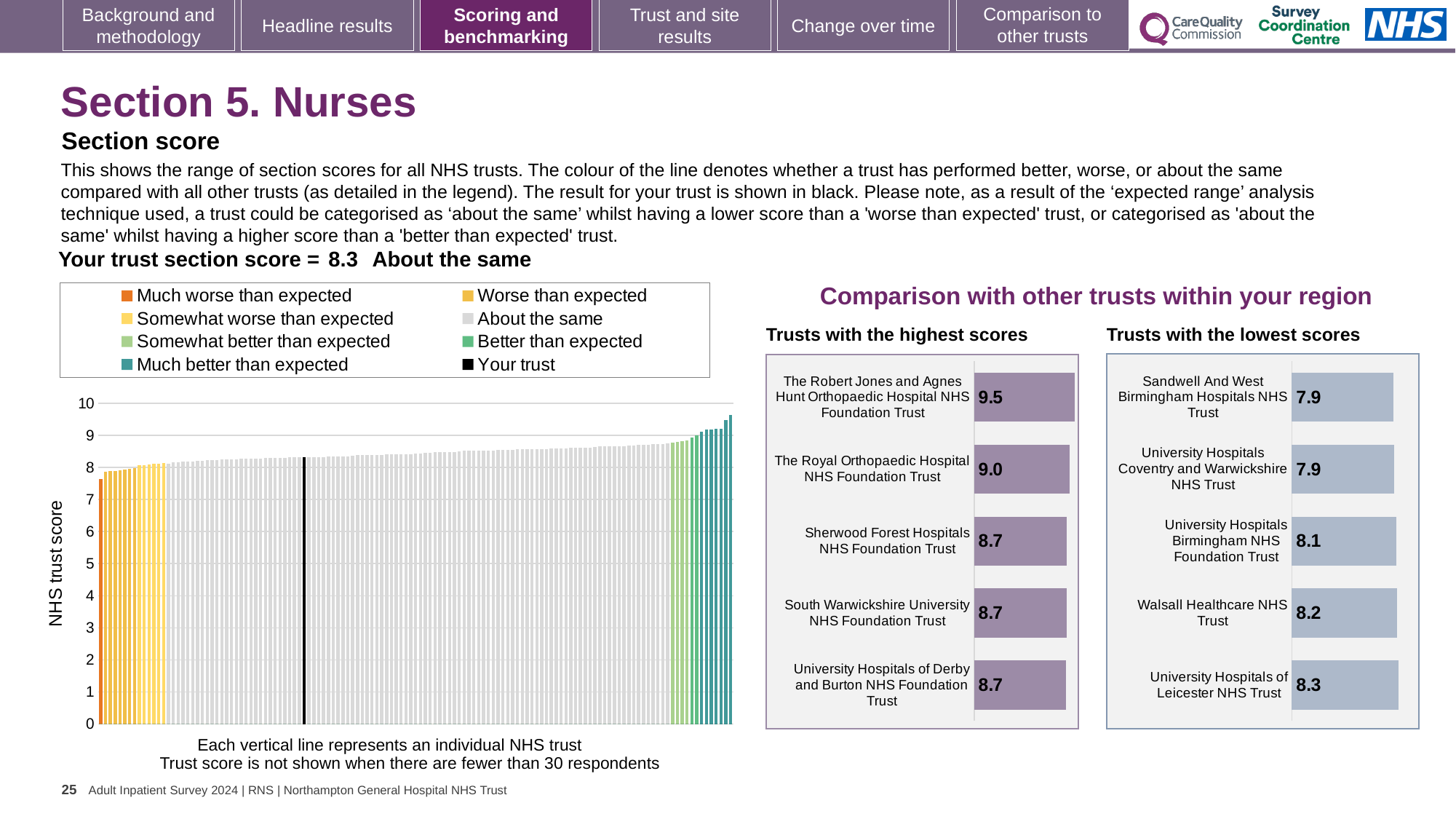
How many trusts are shown in the 'Trusts with the highest scores' chart? 5 In the 'Trusts with the highest scores' chart, which trust has the highest score? The Robert Jones and Agnes Hunt Orthopaedic Hospital NHS Foundation Trust In the 'Trusts with the highest scores' chart, what is the difference between the scores of The Robert Jones and Agnes Hunt Orthopaedic Hospital NHS Foundation Trust and The Royal Orthopaedic Hospital NHS Foundation Trust? 0.5 In the NHS trust score chart on the left, is the value of the lowest (leftmost) bar greater or less than 8? less In the NHS trust score chart on the left, how many entries does the legend list? 8 In the 'Trusts with the highest scores' chart, what is the score for The Robert Jones and Agnes Hunt Orthopaedic Hospital NHS Foundation Trust? 9.5 In the 'Trusts with the highest scores' chart, what is the score for The Royal Orthopaedic Hospital NHS Foundation Trust? 9.0 In the 'Trusts with the lowest scores' chart, what is the difference between the scores of University Hospitals of Leicester NHS Trust and Walsall Healthcare NHS Trust? 0.1 In the 'Trusts with the lowest scores' chart, which trust has the highest score? University Hospitals of Leicester NHS Trust In the 'Trusts with the lowest scores' chart, which has the larger score: University Hospitals Birmingham NHS Foundation Trust or Walsall Healthcare NHS Trust? Walsall Healthcare NHS Trust In the 'Trusts with the lowest scores' chart, what is the score for University Hospitals Birmingham NHS Foundation Trust? 8.1 In the 'Trusts with the lowest scores' chart, what is the score for Walsall Healthcare NHS Trust? 8.2